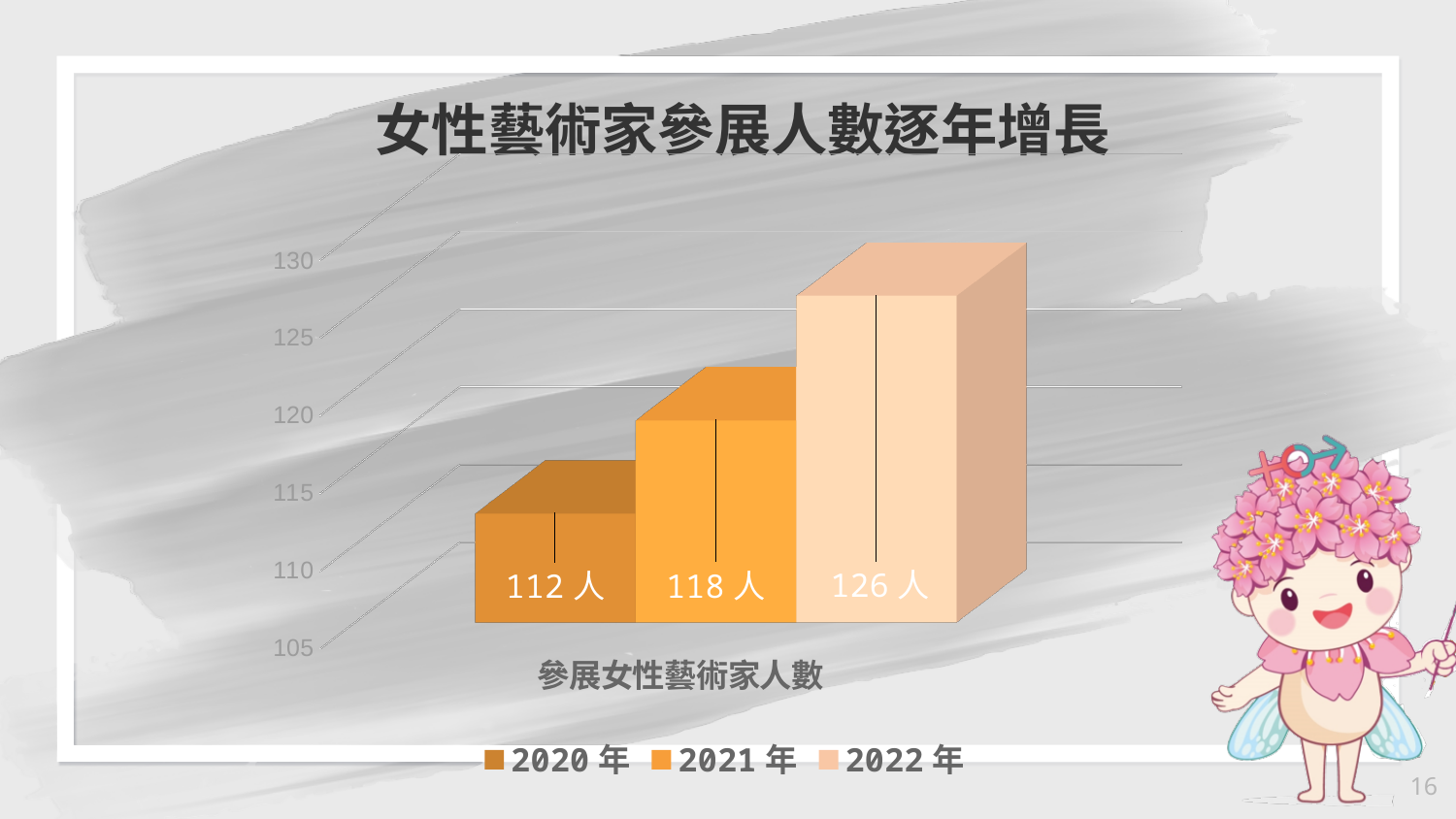
Which year has the highest value? 2022 年 Which year has the lowest value? 2020 年 What is the title of the chart? 女性藝術家參展人數逐年增長 Is the value for 2022 年 greater or less than 120? greater What is the difference between the values for 2021 年 and 2020 年? 6 人 What is the difference between the values for 2022 年 and 2020 年? 14 人 What is the value for 2022 年? 126 人 What is the value for 2021 年? 118 人 What kind of chart is shown on the slide? bar chart Which is larger, the value for 2021 年 or the value for 2022 年? 2022 年 How many series does the legend list? 3 What is the value for 2020 年? 112 人